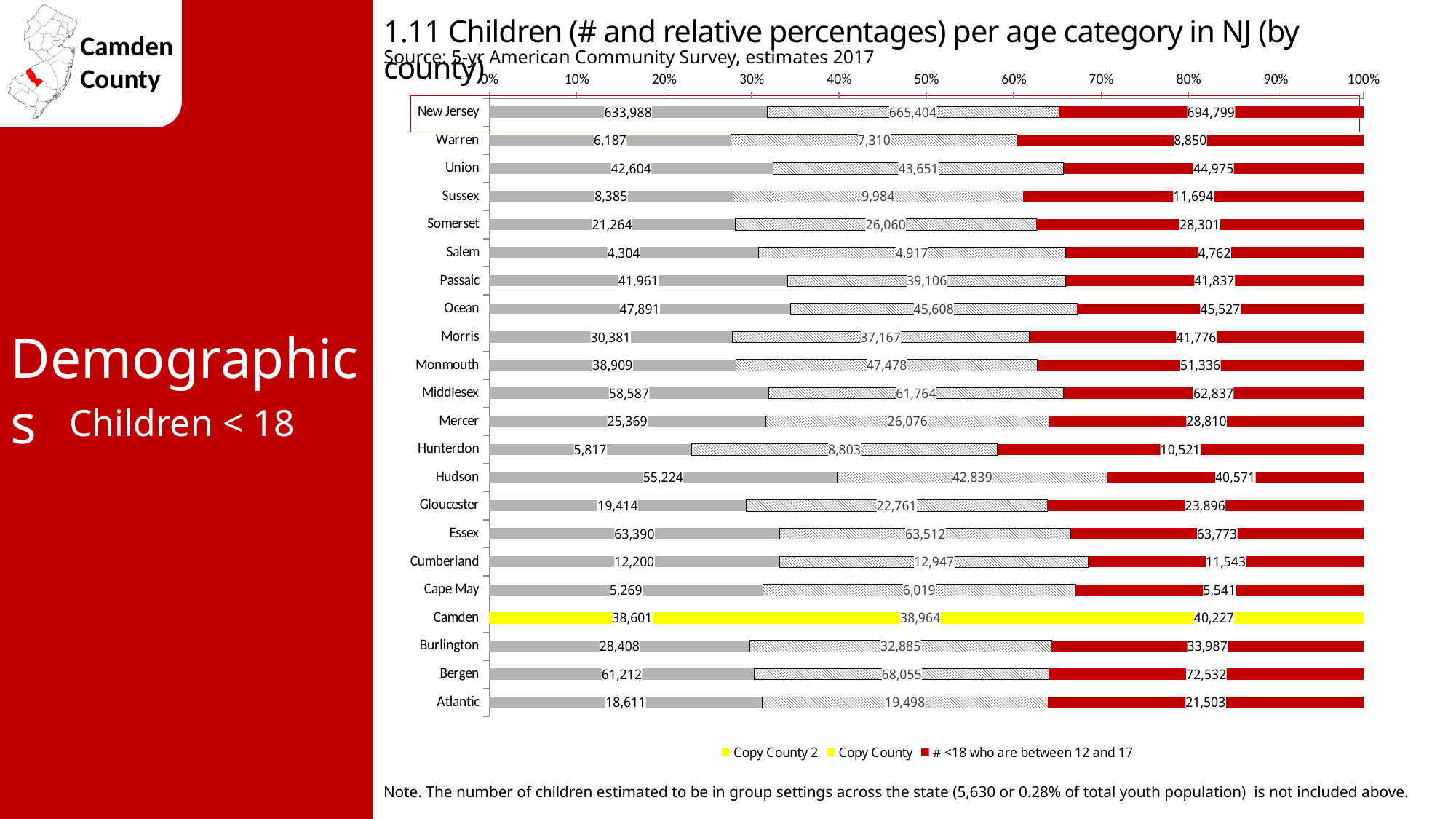
What is the total of the three segments for Camden? 117,792 Excluding the New Jersey row, which county has the smallest '# <18 who are between 12 and 17' value? Salem What is the difference between the rightmost segment (72,532) and the leftmost segment (61,212) for Bergen? 11,320 What is the value of the '# <18 who are between 12 and 17' segment for New Jersey? 694,799 How many counties/rows are plotted in the chart (including New Jersey)? 22 What kind of chart is shown on the slide? bar chart Which row is highlighted in yellow in the chart? Camden What is the value of the first (leftmost) segment for Hudson? 55,224 What is the value of the '# <18 who are between 12 and 17' segment for Camden? 40,227 What is the value of the middle segment for Bergen? 68,055 How many series does the legend list? 3 Excluding the New Jersey row, which county has the largest '# <18 who are between 12 and 17' value? Bergen